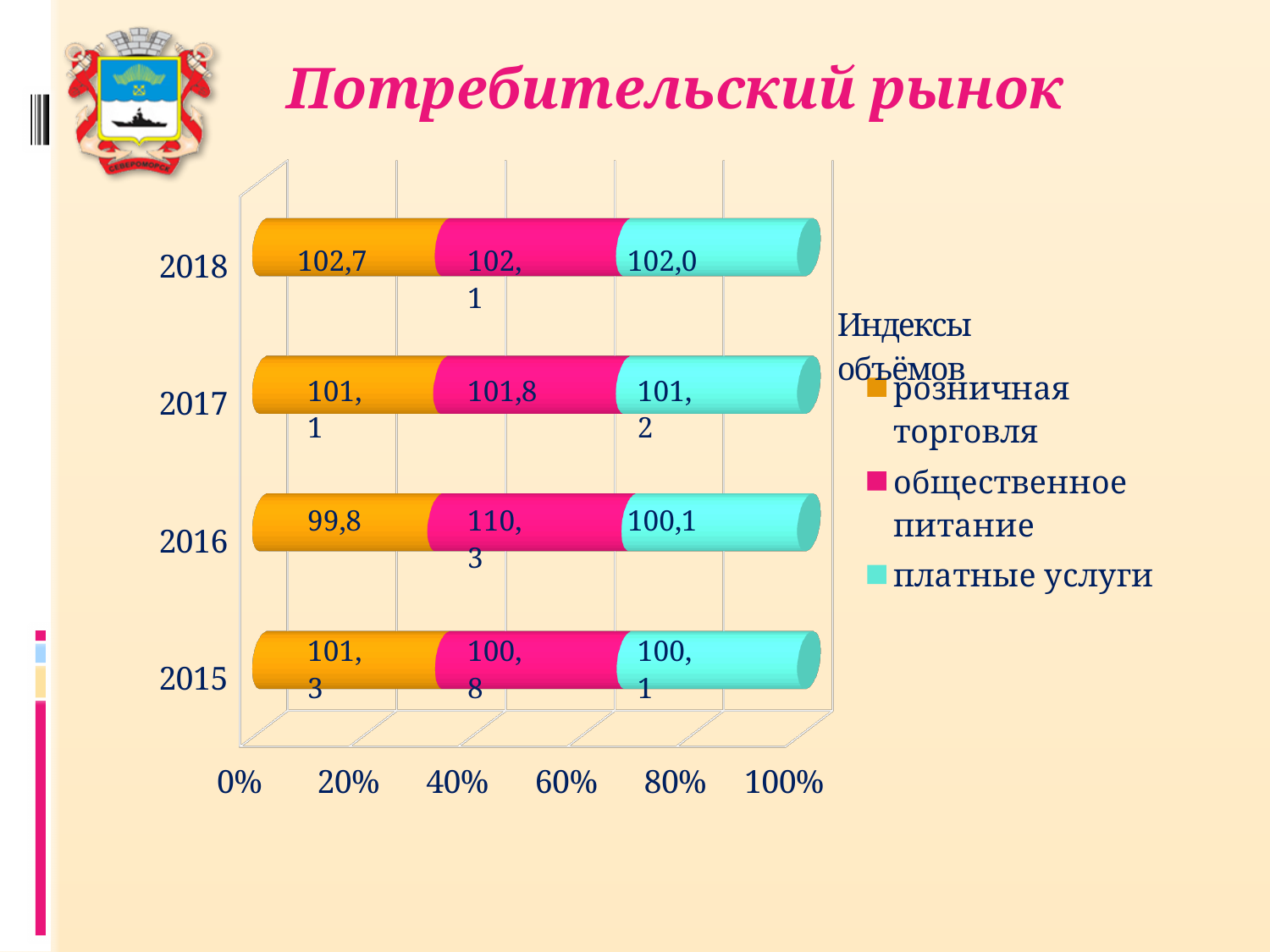
What is the difference between the общественное питание value in 2016 and in 2015? 9,5 Which is larger in 2017: розничная торговля or общественное питание? общественное питание In which year is the value for розничная торговля lowest? 2016 What is the value for розничная торговля in 2015? 101,3 What is the title of the slide? Потребительский рынок How many years are shown on the chart? 4 What is the value for розничная торговля in 2018? 102,7 In which year is the value for общественное питание highest? 2016 What kind of chart is shown on the slide? stacked bar chart How many series does the legend list? 3 What is the value for общественное питание in 2016? 110,3 What is the value for платные услуги in 2017? 101,2